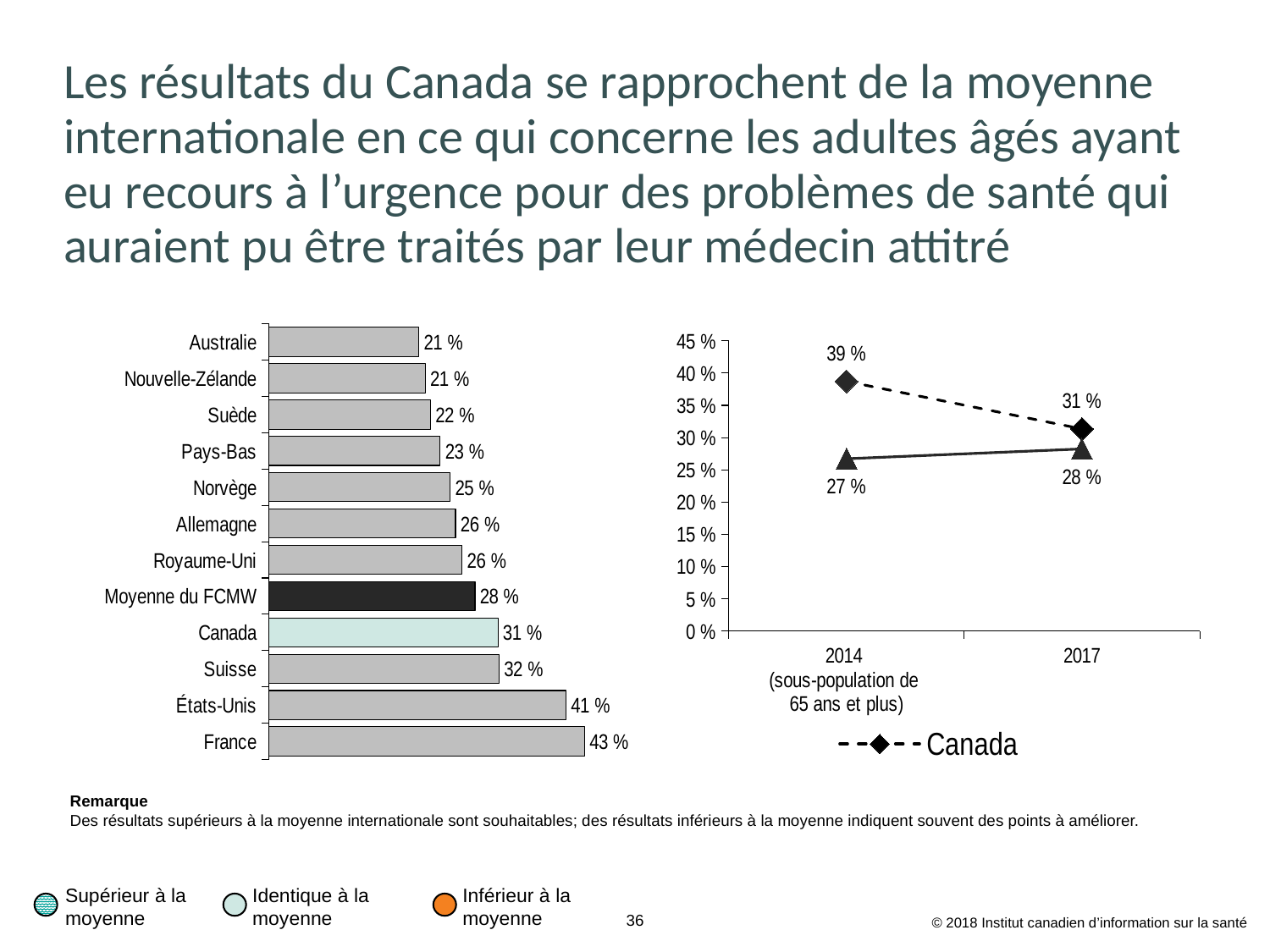
What kind of chart is shown on the left of the slide? Bar chart In the bar chart on the left, how many categories (bars) are shown? 12 In the line chart on the right, what is the value for Canada in 2017? 31 % In the bar chart on the left, what is the value for États-Unis? 41 % In the bar chart on the left, what is the value for Moyenne du FCMW? 28 % In the line chart on the right, what is the difference between the Canada values for 2014 and 2017? 8 % In the line chart on the right, what is the value for Canada in 2014? 39 % In the line chart on the right, does the Canada series rise or fall from 2014 to 2017? Fall In the bar chart on the left, what is the value for Canada? 31 % In the bar chart on the left, which country has the highest value? France In the bar chart on the left, what is the difference between the values for France and Australie? 22 % In the bar chart on the left, which is larger, the value for Suisse or the value for Norvège? Suisse